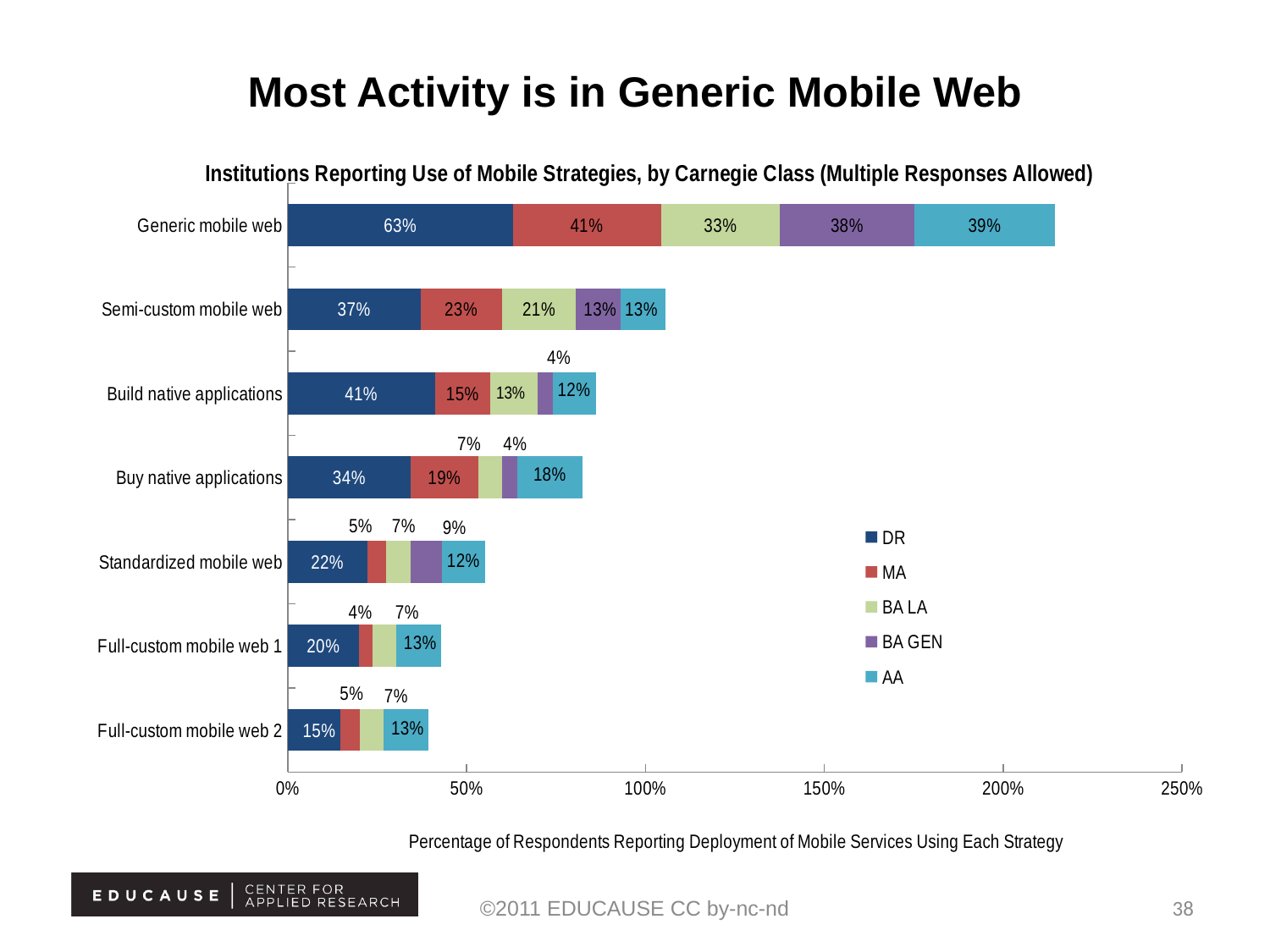
What is the BA GEN value for Standardized mobile web? 9% Which strategy has the shortest total stacked bar? Full-custom mobile web 2 Which is larger: the MA value for Semi-custom mobile web or the MA value for Buy native applications? Semi-custom mobile web What is the total of the stacked bar for Generic mobile web? 214% Which strategy has the longest total stacked bar? Generic mobile web How many mobile strategy categories are plotted on the chart? 7 What is the DR value for Generic mobile web? 63% What is the AA value for Buy native applications? 18% How many series does the legend list? 5 What kind of chart is shown on the slide? Stacked bar chart Is the total stacked bar for Build native applications greater or less than 100%? less What is the difference between the DR value for Generic mobile web and the DR value for Semi-custom mobile web? 26 percentage points